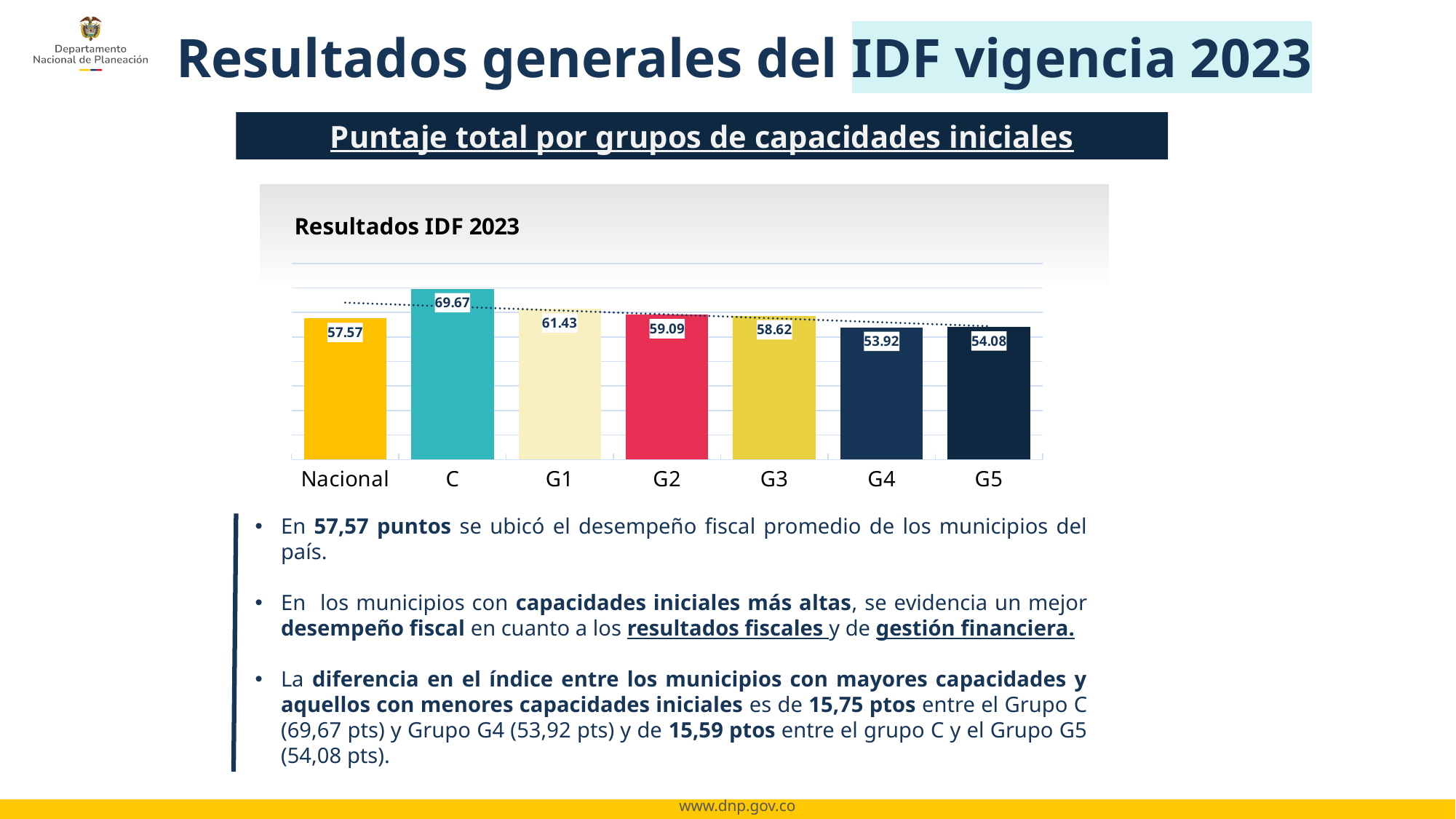
Which is larger in the Resultados IDF 2023 chart, the value for G1 or the value for G2? G1 What is the value for Nacional in the Resultados IDF 2023 chart? 57.57 What kind of chart is the Resultados IDF 2023 chart? bar chart What is the title of the chart on the slide? Resultados IDF 2023 Which category has the lowest value in the Resultados IDF 2023 chart? G4 How many categories are shown in the Resultados IDF 2023 chart? 7 Which is larger in the Resultados IDF 2023 chart, the value for Nacional or the value for G3? G3 What is the difference between the values for G1 and G3 in the Resultados IDF 2023 chart? 2.81 What is the difference between the values for C and G4 in the Resultados IDF 2023 chart? 15.75 What is the value for G2 in the Resultados IDF 2023 chart? 59.09 What is the value for G5 in the Resultados IDF 2023 chart? 54.08 Which category has the highest value in the Resultados IDF 2023 chart? C